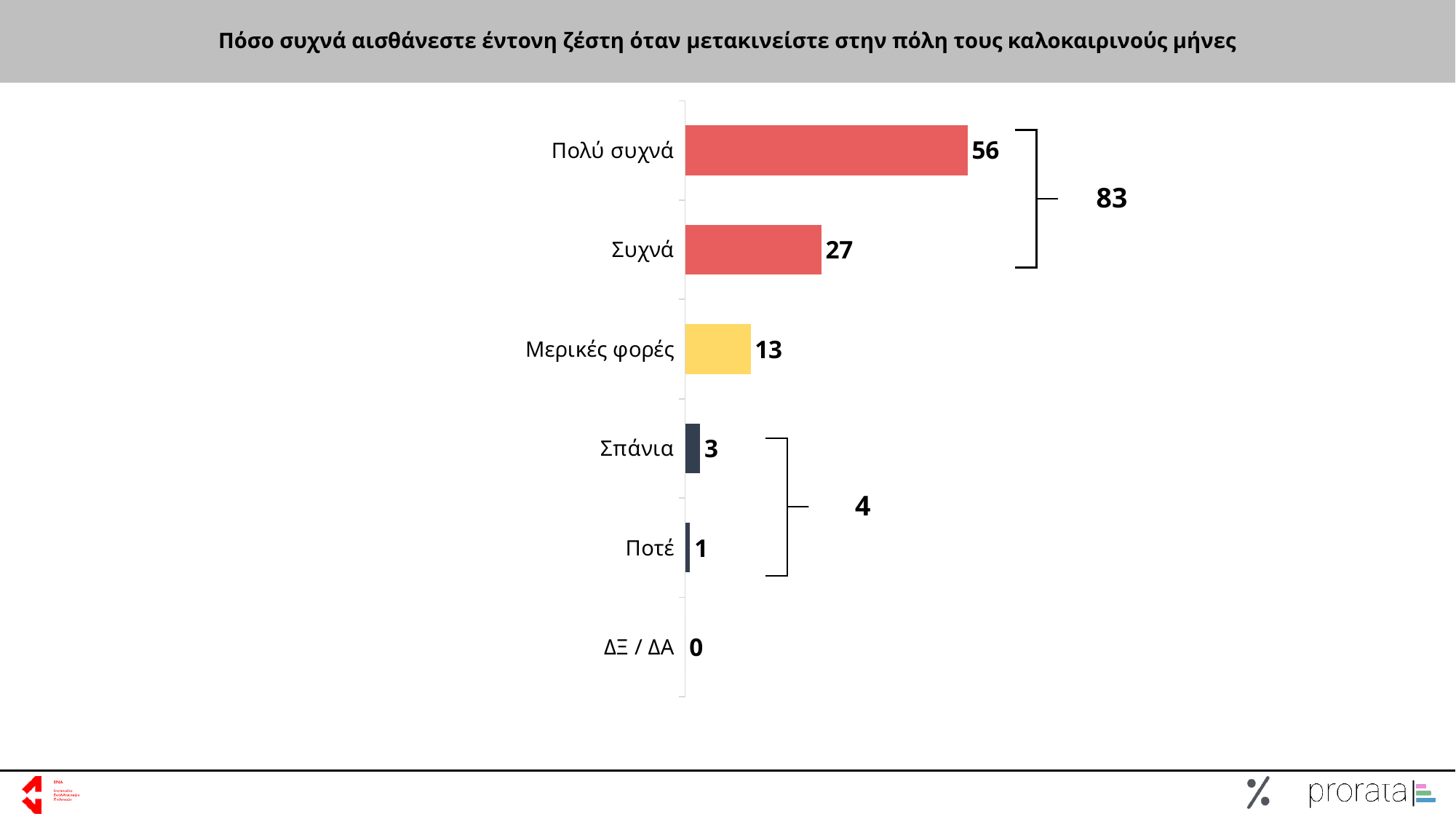
What is the value for Πολύ συχνά? 56 Which is larger, the value for Μερικές φορές or the value for Σπάνια? Μερικές φορές What combined value is shown by the bracket grouping Σπάνια and Ποτέ? 4 What is the value for Μερικές φορές? 13 What is the value for Συχνά? 27 Which category has the lowest value? ΔΞ / ΔΑ What kind of chart is shown on the slide? Bar chart How many categories are shown in the chart? 6 What is the value for Ποτέ? 1 Which category has the highest value? Πολύ συχνά What combined value is shown by the bracket grouping Πολύ συχνά and Συχνά? 83 What is the difference between the values for Πολύ συχνά and Συχνά? 29